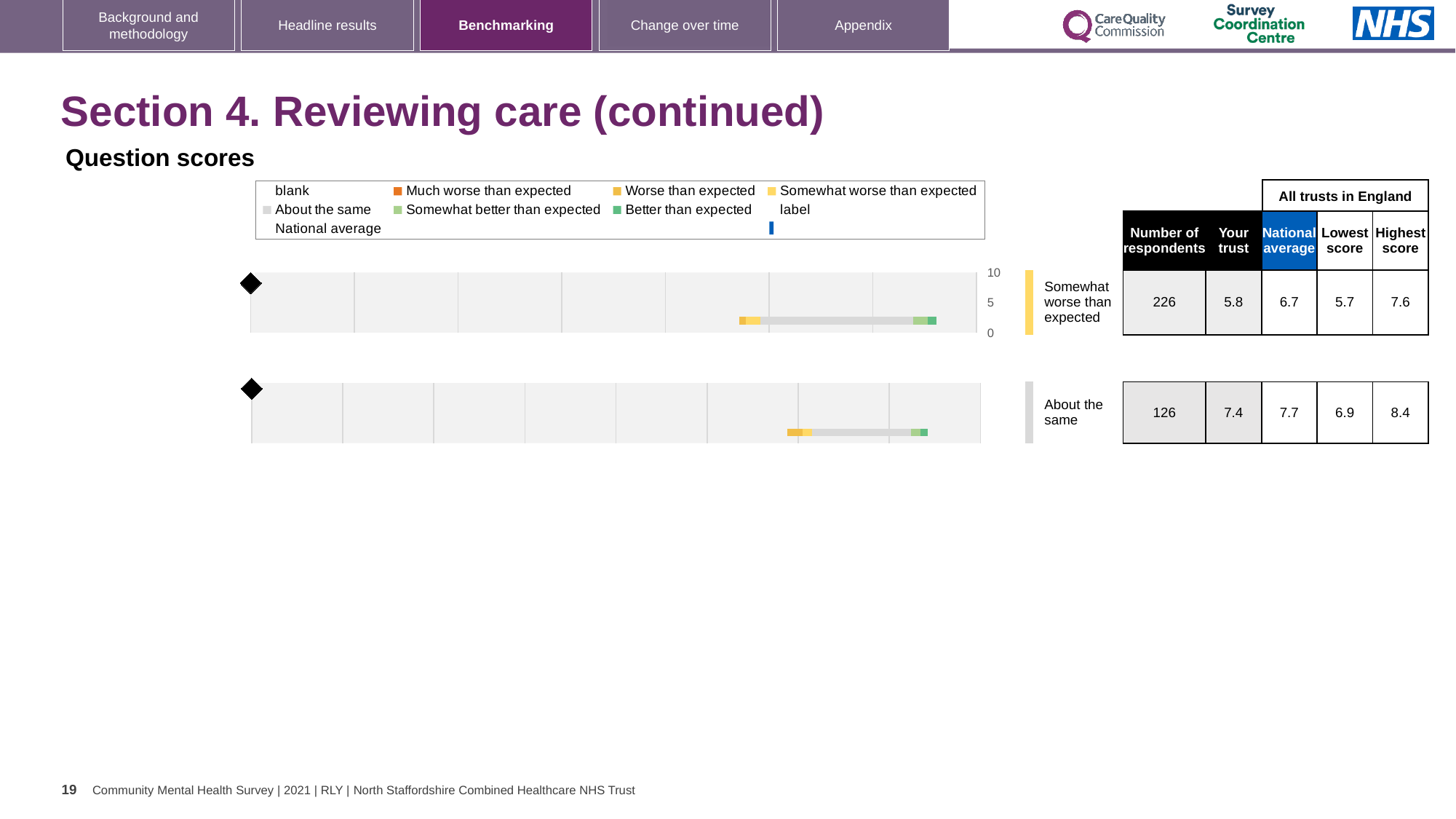
For the top chart (rated 'Somewhat worse than expected'), what is the difference between the highest score and the lowest score? 1.9 For the bottom chart (rated 'About the same'), what is the highest score among all trusts in England? 8.4 What is the maximum value shown on the score axis of the top chart? 10 For the bottom chart (rated 'About the same'), what is the number of respondents? 126 What kind of chart is used to show the question scores on this slide? bar chart For the top chart (rated 'Somewhat worse than expected'), what is the national average? 6.7 How many question score charts are shown on the slide? 2 For the top chart (rated 'Somewhat worse than expected'), which is larger: the 'Your trust' score or the national average? National average What benchmark category label is shown next to the bottom chart? About the same Which of the two charts has the higher number of respondents? The top chart (Somewhat worse than expected) For the top chart (rated 'Somewhat worse than expected'), what is the 'Your trust' score? 5.8 For the bottom chart (rated 'About the same'), what is the difference between the national average and the 'Your trust' score? 0.3